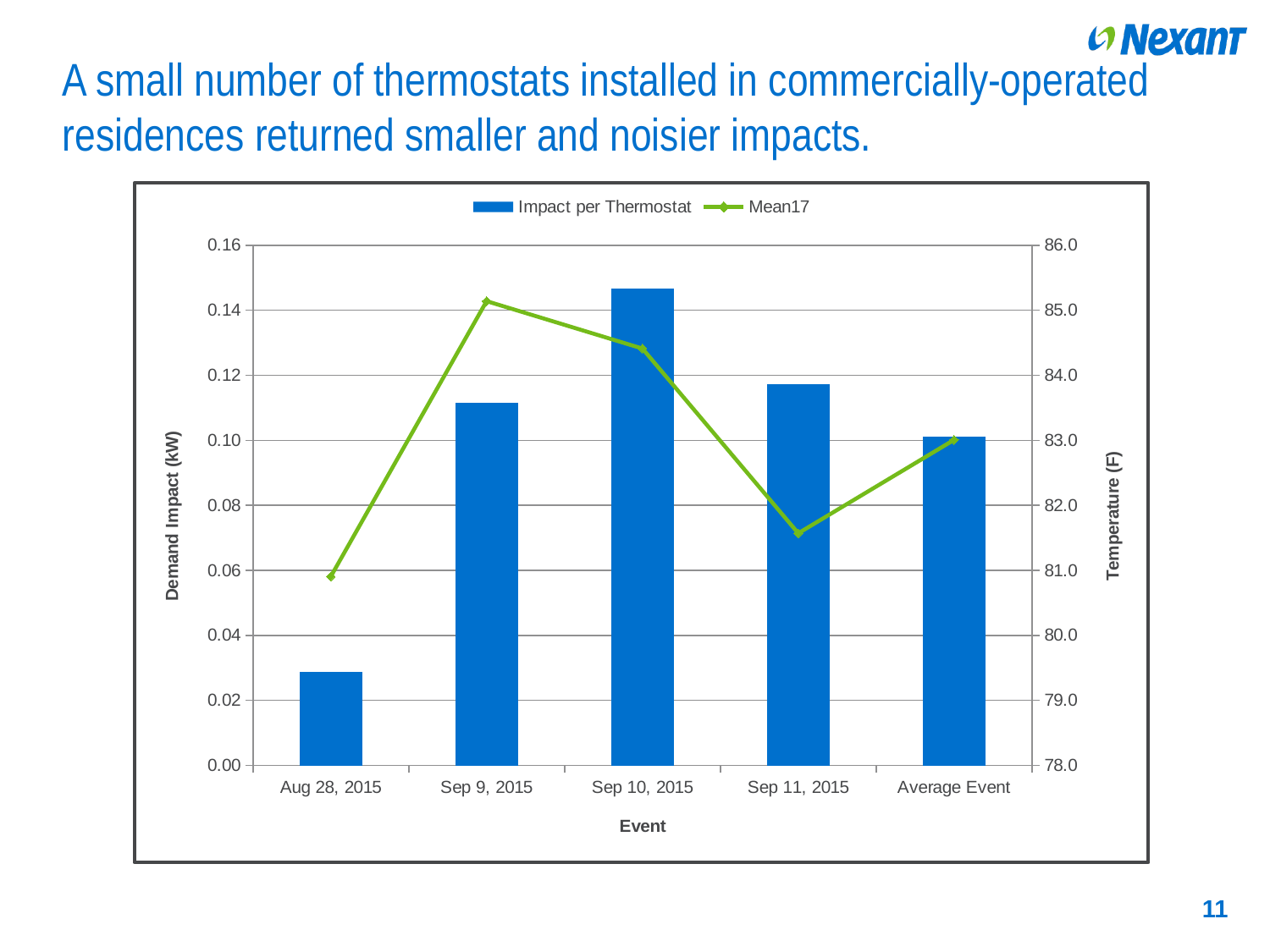
Is the Impact per Thermostat for Aug 28, 2015 greater or less than 0.04 kW? less How many events are shown on the x axis? 5 Which event has the highest Mean17 temperature? Sep 9, 2015 Which event has the lowest Impact per Thermostat? Aug 28, 2015 Which is larger, the Impact per Thermostat for Sep 11, 2015 or for Sep 9, 2015? Sep 11, 2015 Is the Impact per Thermostat for Sep 10, 2015 greater or less than 0.14 kW? greater What kind of chart is shown on the slide? A combined bar and line chart How many series does the legend list? 2 Which event has the highest Impact per Thermostat? Sep 10, 2015 What is the label of the left vertical axis? Demand Impact (kW)